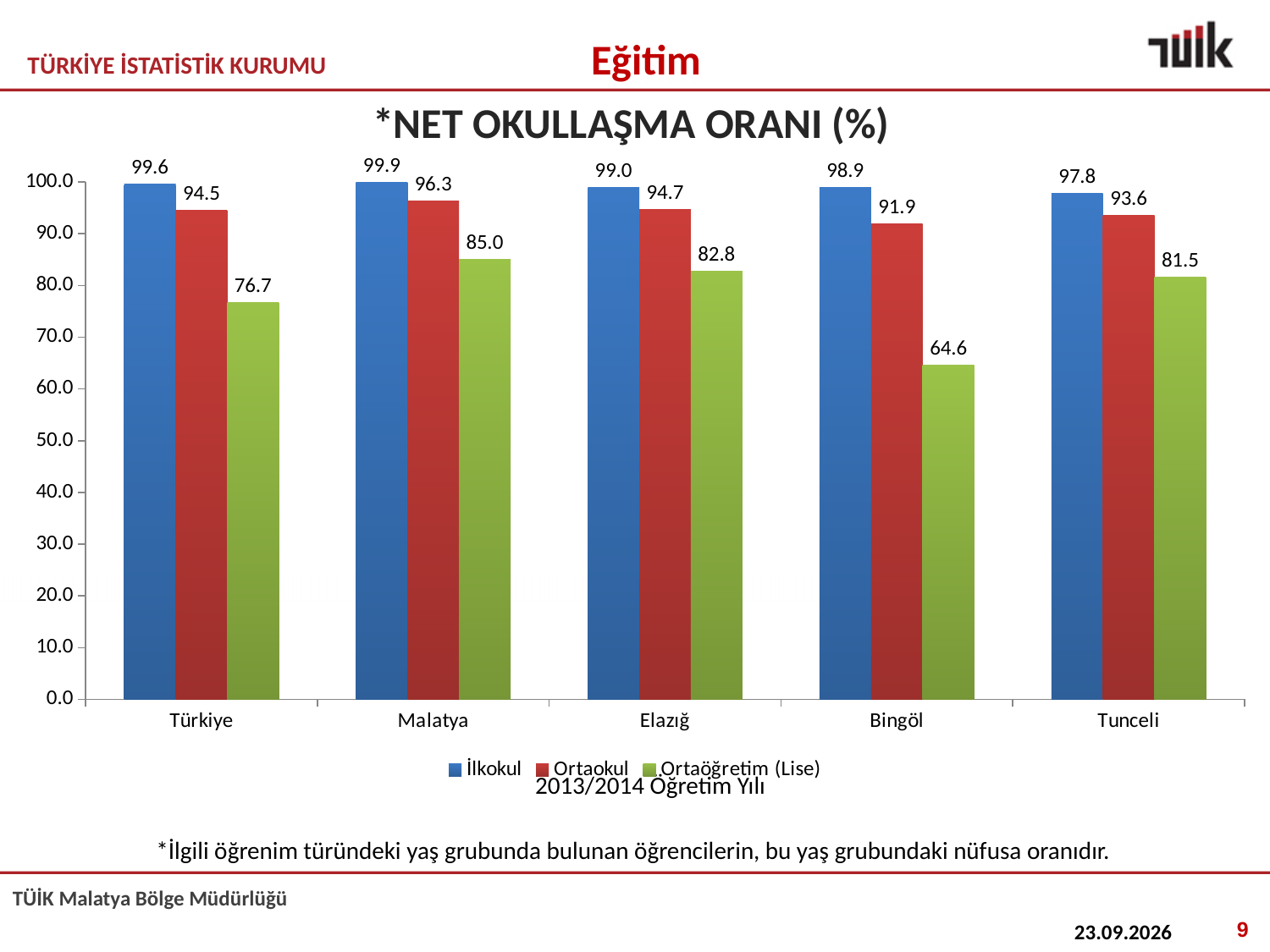
How many series does the legend list? 3 What is the İlkokul value for Malatya? 99.9 Which category has the lowest Ortaöğretim (Lise) value? Bingöl What is the difference between the İlkokul and Ortaöğretim (Lise) values for Türkiye? 22.9 What is the Ortaöğretim (Lise) value for Bingöl? 64.6 What is the title of the chart? *NET OKULLAŞMA ORANI (%) How many categories are shown on the x axis? 5 What is the Ortaokul value for Tunceli? 93.6 What kind of chart is shown on the slide? Bar chart Which is larger, the Ortaöğretim (Lise) value for Elazığ or for Tunceli? Elazığ Which series is shown in green? Ortaöğretim (Lise) Which category has the highest Ortaokul value? Malatya